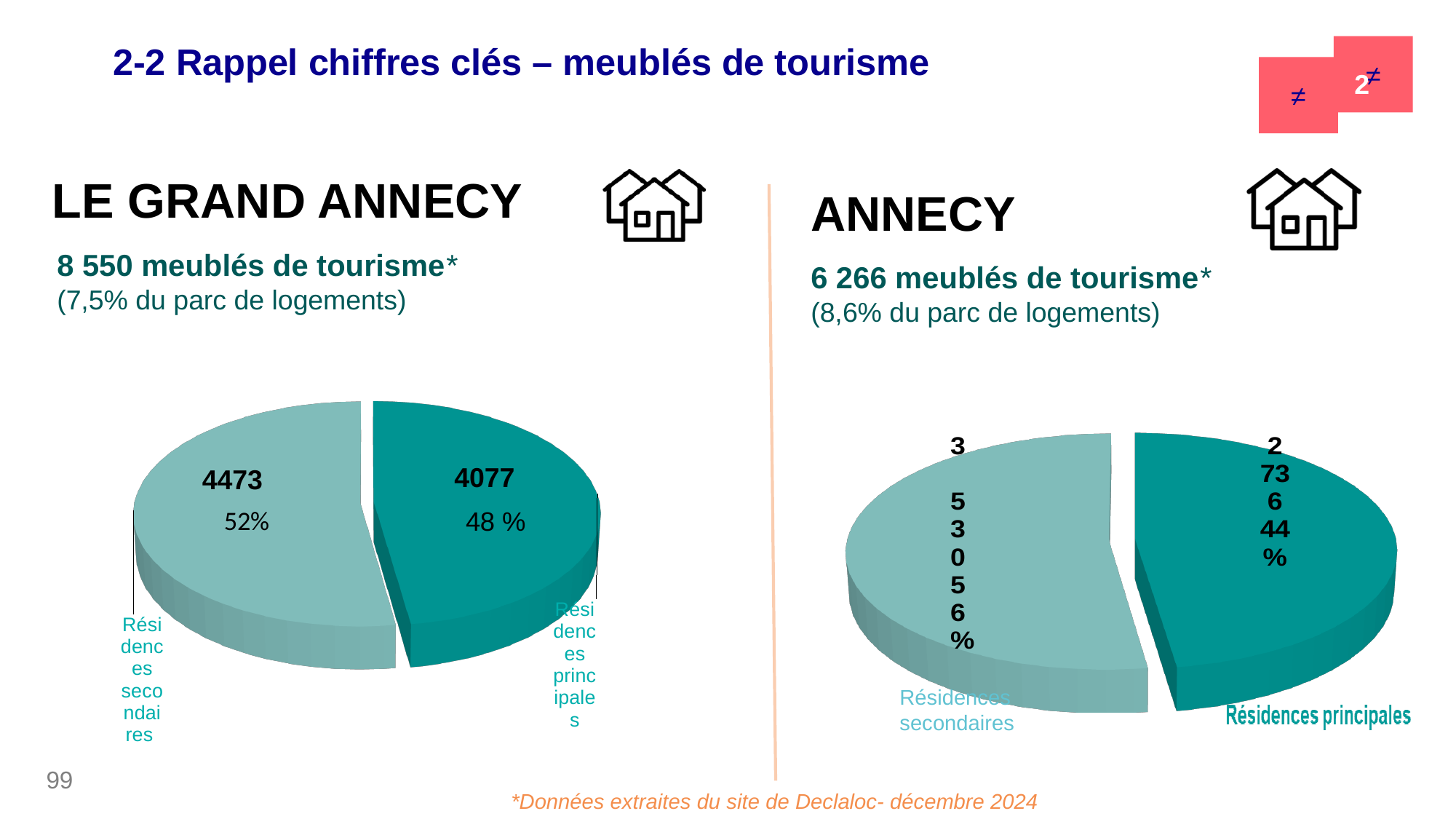
In the Le Grand Annecy pie chart, what is the difference between Résidences secondaires and Résidences principales? 396 In the Annecy pie chart, what share of the pie do Résidences secondaires represent? 56% In the Le Grand Annecy pie chart, what share of the pie do Résidences secondaires represent? 52% How many slices does the Annecy pie chart have? 2 What kind of chart is used on the left side of the slide for Le Grand Annecy? Pie chart In the Annecy pie chart, which is larger, Résidences secondaires or Résidences principales? Résidences secondaires In the Le Grand Annecy pie chart, how many Résidences principales are shown? 4077 In the Annecy pie chart, what share of the pie do Résidences principales represent? 44% In the Annecy pie chart, which category is the smallest? Résidences principales In the Le Grand Annecy pie chart, how many Résidences secondaires are shown? 4473 In the Le Grand Annecy pie chart, which category is the largest? Résidences secondaires